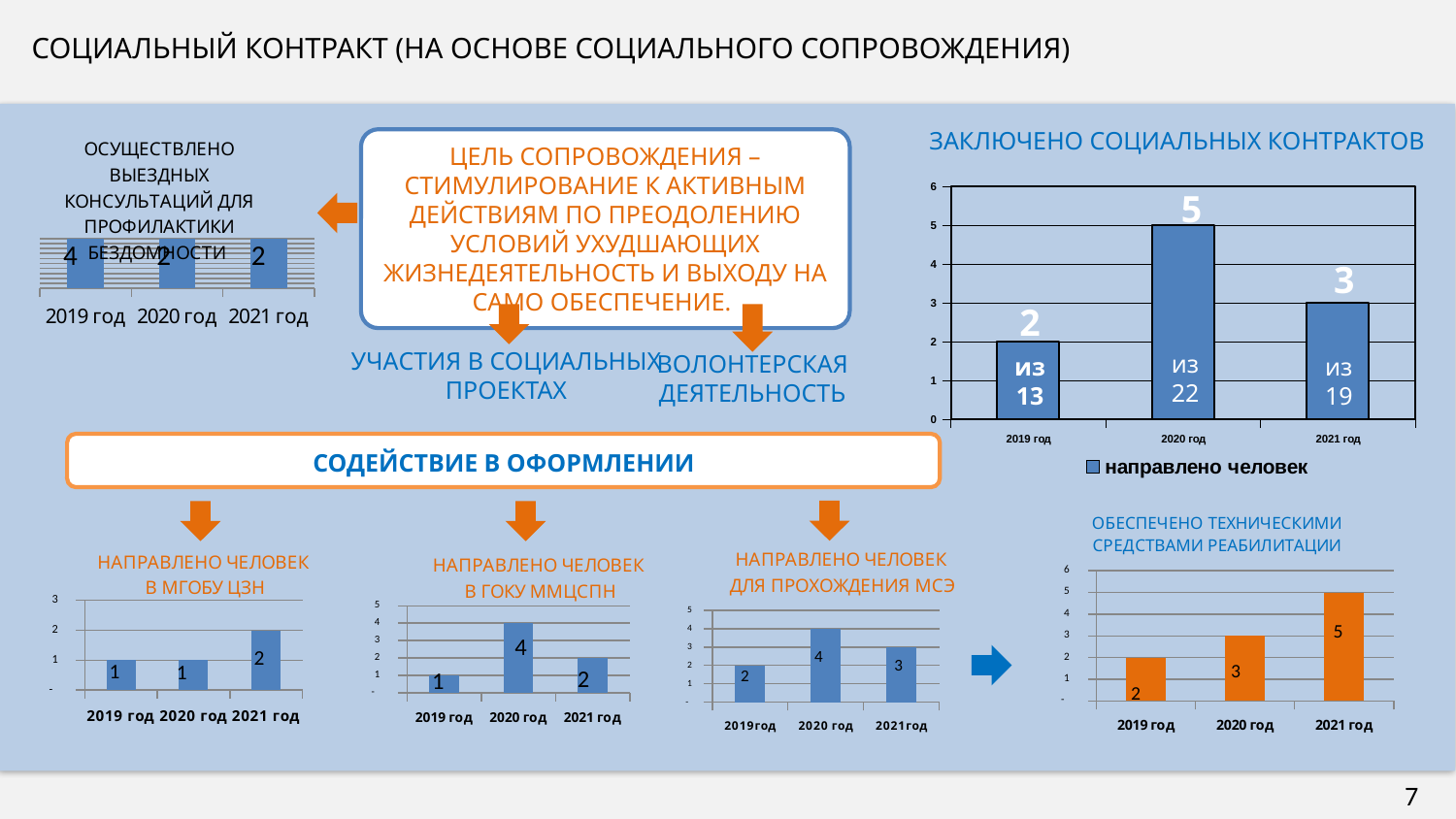
In the chart 'ОБЕСПЕЧЕНО ТЕХНИЧЕСКИМИ СРЕДСТВАМИ РЕАБИЛИТАЦИИ', do the values rise or fall from 2019 год to 2021 год? rise In the chart 'ЗАКЛЮЧЕНО СОЦИАЛЬНЫХ КОНТРАКТОВ', what is the difference between the values for 2020 год and 2021 год? 2 In the chart 'НАПРАВЛЕНО ЧЕЛОВЕК ДЛЯ ПРОХОЖДЕНИЯ МСЭ', what is the value for 2021 год? 3 What kind of chart is 'ОСУЩЕСТВЛЕНО ВЫЕЗДНЫХ КОНСУЛЬТАЦИЙ ДЛЯ ПРОФИЛАКТИКИ БЕЗДОМНОСТИ'? bar chart In the chart 'ЗАКЛЮЧЕНО СОЦИАЛЬНЫХ КОНТРАКТОВ', what is the value for 2020 год? 5 In the chart 'НАПРАВЛЕНО ЧЕЛОВЕК В ГОКУ ММЦСПН', what is the value for 2019 год? 1 In the chart 'НАПРАВЛЕНО ЧЕЛОВЕК В МГОБУ ЦЗН', what is the value for 2021 год? 2 In the chart 'ОБЕСПЕЧЕНО ТЕХНИЧЕСКИМИ СРЕДСТВАМИ РЕАБИЛИТАЦИИ', what is the value for 2021 год? 5 In the chart 'ЗАКЛЮЧЕНО СОЦИАЛЬНЫХ КОНТРАКТОВ', which year has the lowest value? 2019 год In the chart 'НАПРАВЛЕНО ЧЕЛОВЕК ДЛЯ ПРОХОЖДЕНИЯ МСЭ', which is larger, the value for 2019 год or 2020 год? 2020 год In the chart 'НАПРАВЛЕНО ЧЕЛОВЕК В ГОКУ ММЦСПН', which year has the highest value? 2020 год In the chart 'ЗАКЛЮЧЕНО СОЦИАЛЬНЫХ КОНТРАКТОВ', what series name does the legend show? направлено человек